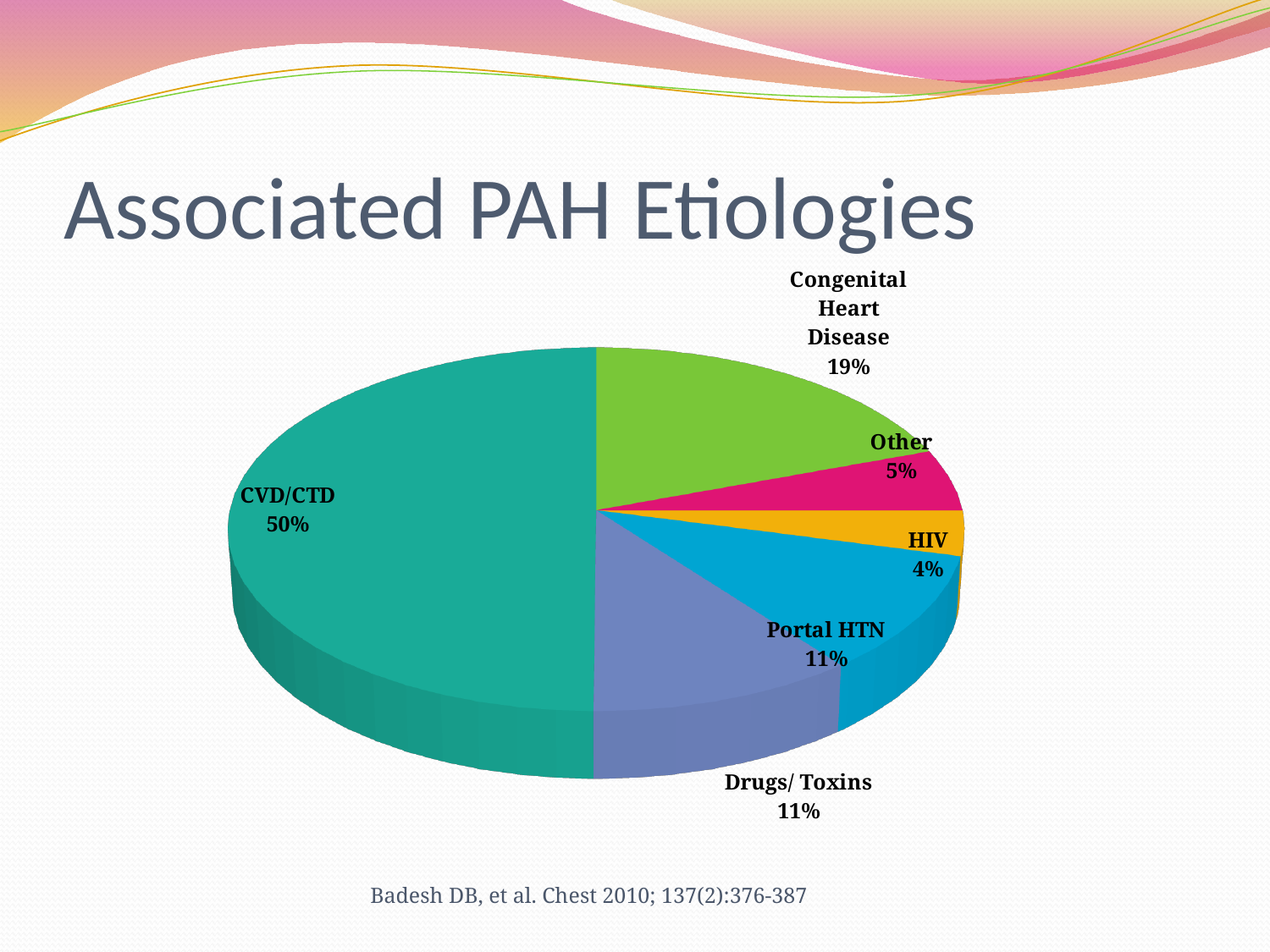
Which category has the smallest slice of the pie? HIV What percentage is shown for HIV? 4% What percentage is shown for Portal HTN? 11% How many slices does the pie chart have? 6 What percentage is shown for Congenital Heart Disease? 19% Which category has the largest slice of the pie? CVD/CTD What is the difference in percentage points between CVD/CTD and Congenital Heart Disease? 31 What kind of chart is shown on the slide? pie chart What share of the pie does CVD/CTD represent? 50% Which is larger, the share for Other or the share for HIV? Other What is the combined share of Drugs/Toxins and Portal HTN? 22% What is the title of the slide containing the pie chart? Associated PAH Etiologies